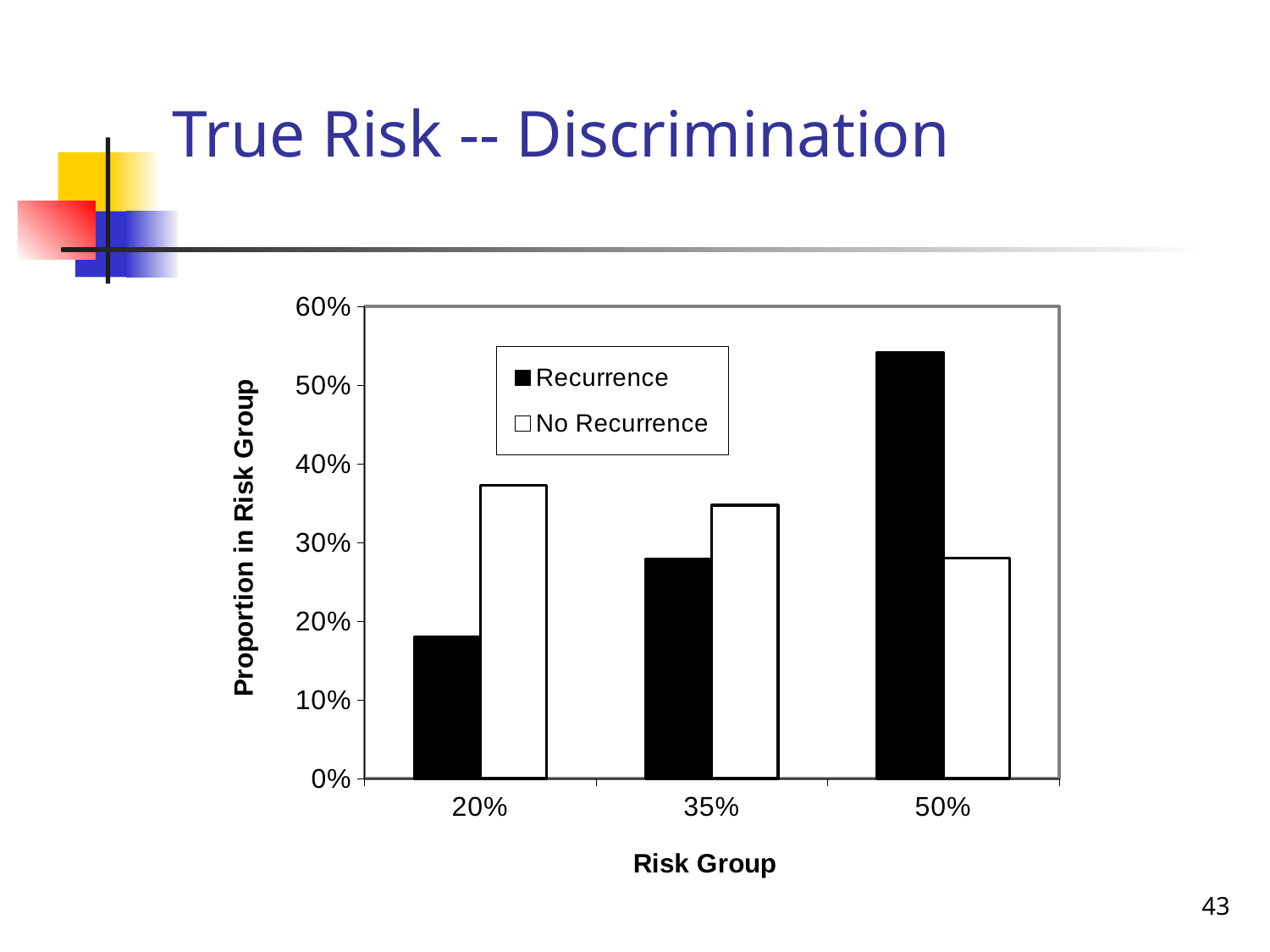
Which risk group has the lowest Recurrence value? 20% Do the Recurrence values rise or fall as the risk group increases from 20% to 50%? rise Which risk group has the highest Recurrence value? 50% How many risk groups are shown on the x axis? 3 How many series does the legend list? 2 Which risk group has the lowest No Recurrence value? 50% Is the No Recurrence value for the 20% risk group greater or less than 30%? greater Is the Recurrence value for the 50% risk group greater or less than 50%? greater In the 20% risk group, which is larger: Recurrence or No Recurrence? No Recurrence Is the Recurrence value for the 20% risk group greater or less than 20%? less What kind of chart is shown on the slide? bar chart In the 50% risk group, which is larger: Recurrence or No Recurrence? Recurrence